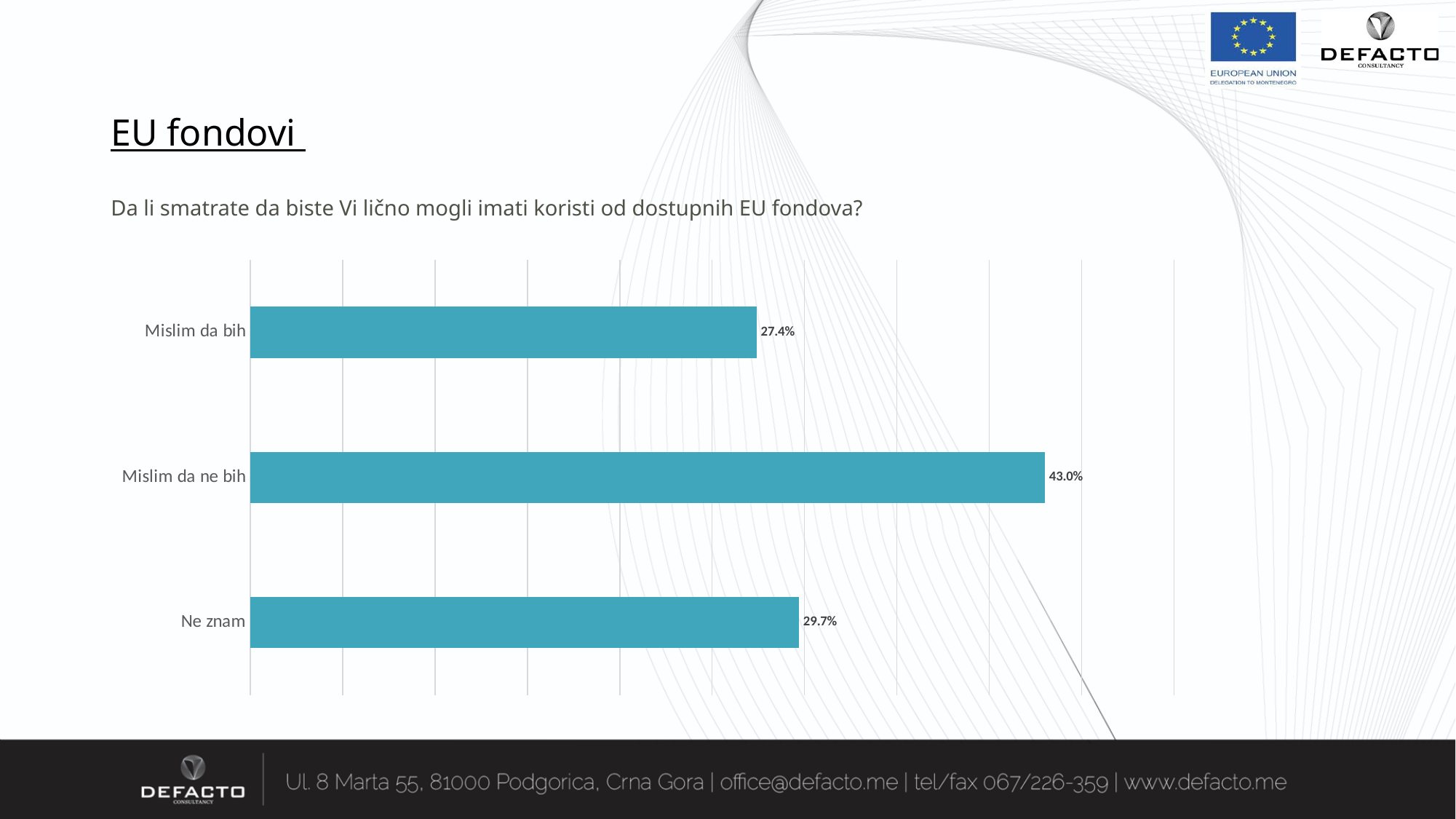
What kind of chart is shown on the slide? Bar chart What is the value for "Mislim da bih"? 27.4% What is the value for "Mislim da ne bih"? 43.0% Which category has the highest value? Mislim da ne bih What survey question is the chart about? Da li smatrate da biste Vi lično mogli imati koristi od dostupnih EU fondova? Which is larger, the value for "Ne znam" or the value for "Mislim da bih"? Ne znam What is the value for "Ne znam"? 29.7% Which category has the lowest value? Mislim da bih What is the total of the three values shown in the chart? 100.1% How many categories are shown in the chart? 3 What is the difference between the values for "Ne znam" and "Mislim da bih"? 2.3% What is the difference between the values for "Mislim da ne bih" and "Mislim da bih"? 15.6%